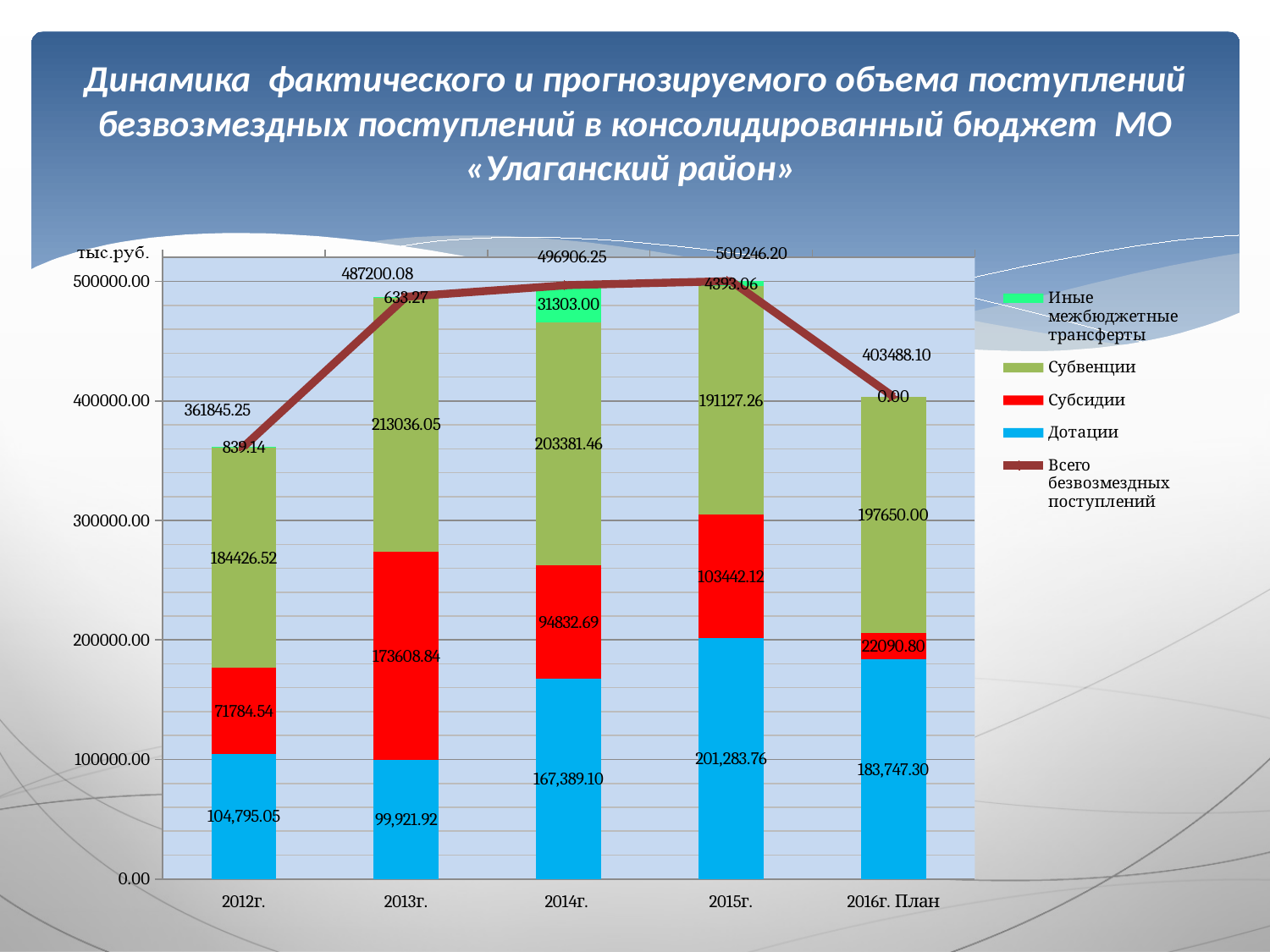
Which is larger: Субвенции in 2013г. or Субвенции in 2014г.? Субвенции in 2013г. What is the value of Дотации for 2015г.? 201,283.76 What kind of chart is shown on the slide? Stacked bar chart with a line In which year is Дотации lowest? 2013г. How many series does the legend list? 5 What is the value of Субсидии for 2013г.? 173608.84 What is the difference between Субсидии in 2015г. and Субсидии in 2016г. План? 81351.32 What is the value of Иные межбюджетные трансферты for 2014г.? 31303.00 In which year is Всего безвозмездных поступлений highest? 2015г. What is the total of Всего безвозмездных поступлений for 2012г.? 361845.25 What is the value of Субвенции for 2016г. План? 197650.00 How many years are shown on the x axis? 5